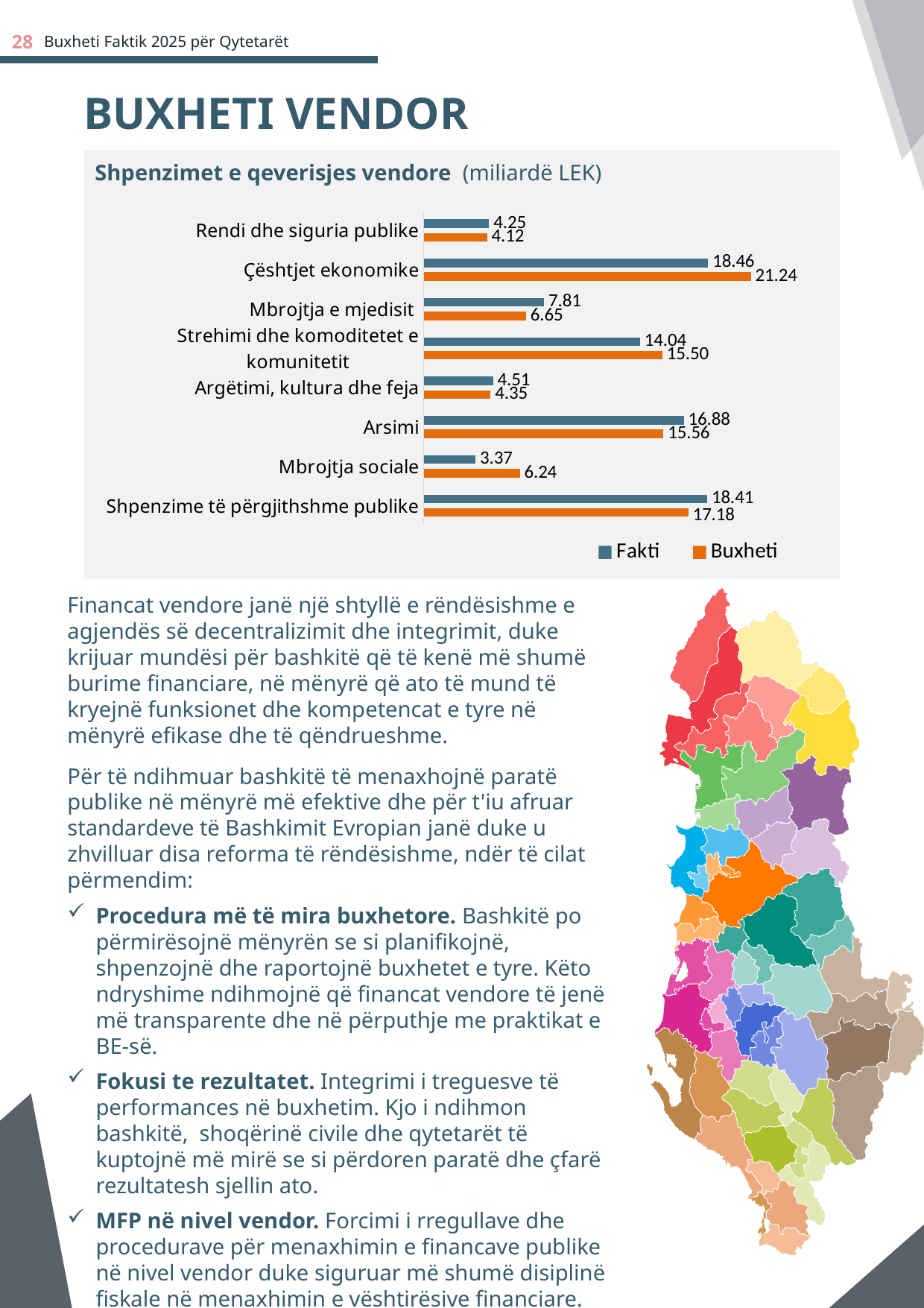
Which category has the lowest Fakti value? Mbrojtja sociale What is the difference between the Buxheti and Fakti values for Mbrojtja sociale? 2.87 What is the Buxheti value for Çështjet ekonomike? 21.24 For Arsimi, which is larger: the Fakti value or the Buxheti value? Fakti What is the Fakti value for Strehimi dhe komoditetet e komunitetit? 14.04 Which category has the highest Buxheti value? Çështjet ekonomike What kind of chart is shown on the slide? Bar chart How many series does the legend list? 2 What is the Buxheti value for Mbrojtja sociale? 6.24 How many categories are shown in the chart? 8 What is the difference between the Buxheti and Fakti values for Çështjet ekonomike? 2.78 What is the Fakti value for Arsimi? 16.88